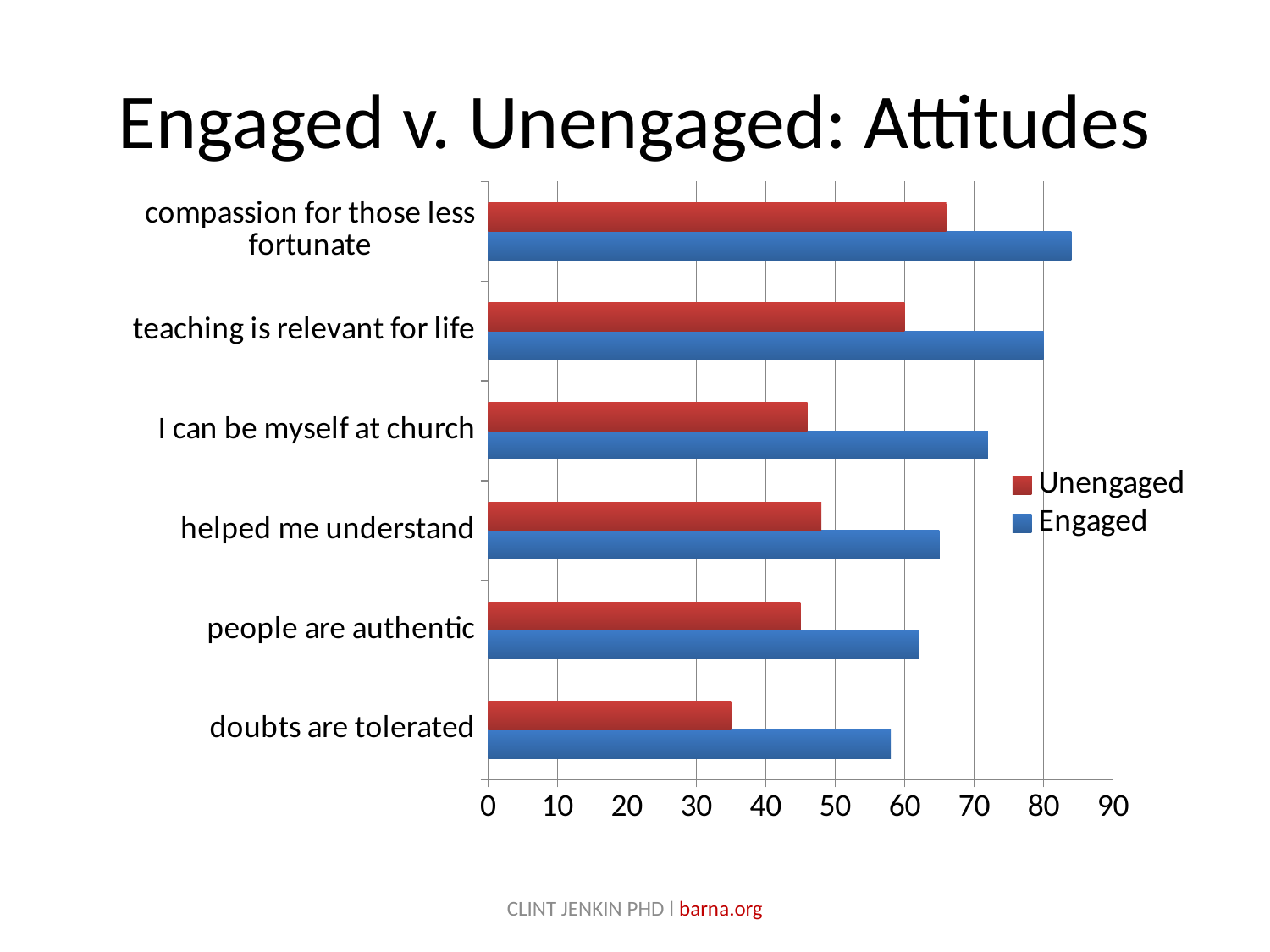
What is the Unengaged value for 'teaching is relevant for life'? 60 Which category has the lowest Unengaged value? doubts are tolerated Is the Engaged value for 'people are authentic' greater or less than 60? greater What kind of chart is shown on the slide? bar chart How many series does the legend list? 2 Which category has the highest Engaged value? compassion for those less fortunate What is the Engaged value for 'teaching is relevant for life'? 80 How many attitude categories are plotted on the chart? 6 Is the Engaged value for 'compassion for those less fortunate' greater or less than 80? greater Which colour represents the Unengaged series in the legend? red For 'I can be myself at church', which is larger: the Engaged or the Unengaged value? Engaged Is the Unengaged value for 'doubts are tolerated' greater or less than 40? less